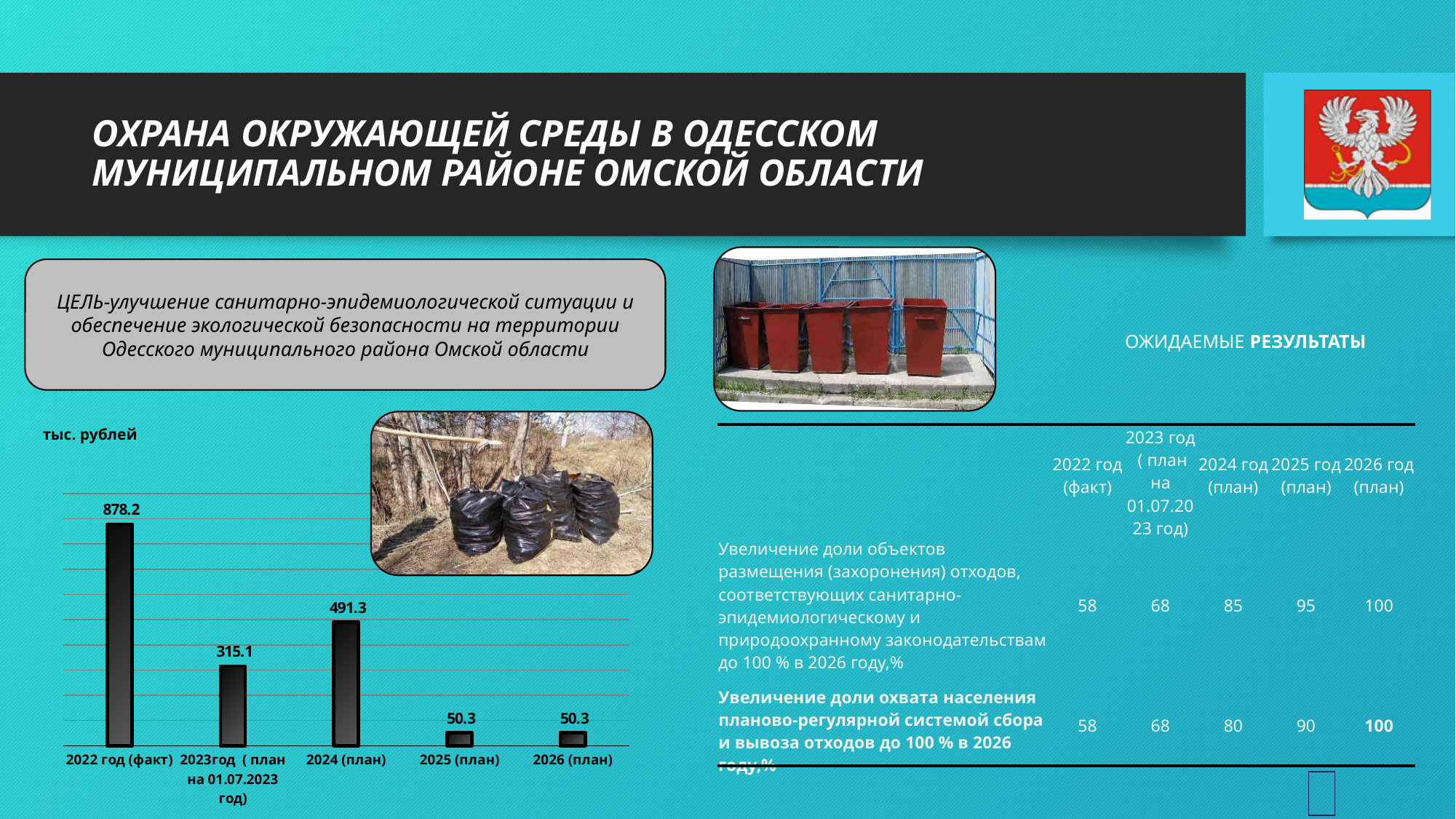
What is the value for 2024 (план) on the bar chart? 491.3 What is the value for 2025 (план) on the bar chart? 50.3 Which category has the highest value on the bar chart? 2022 год (факт) What unit is indicated above the bar chart? тыс. рублей Which is larger on the bar chart: the value for 2024 (план) or the value for 2023год (план на 01.07.2023 год)? 2024 (план) How many categories are shown on the bar chart? 5 What is the value for 2023год (план на 01.07.2023 год) on the bar chart? 315.1 What is the difference between the values for 2022 год (факт) and 2024 (план) on the bar chart? 386.9 What kind of chart is shown on the slide? bar chart What is the difference between the values for 2024 (план) and 2023год (план на 01.07.2023 год) on the bar chart? 176.2 What is the value for 2022 год (факт) on the bar chart? 878.2 Do the values for 2025 (план) and 2026 (план) on the bar chart differ? No, both are 50.3